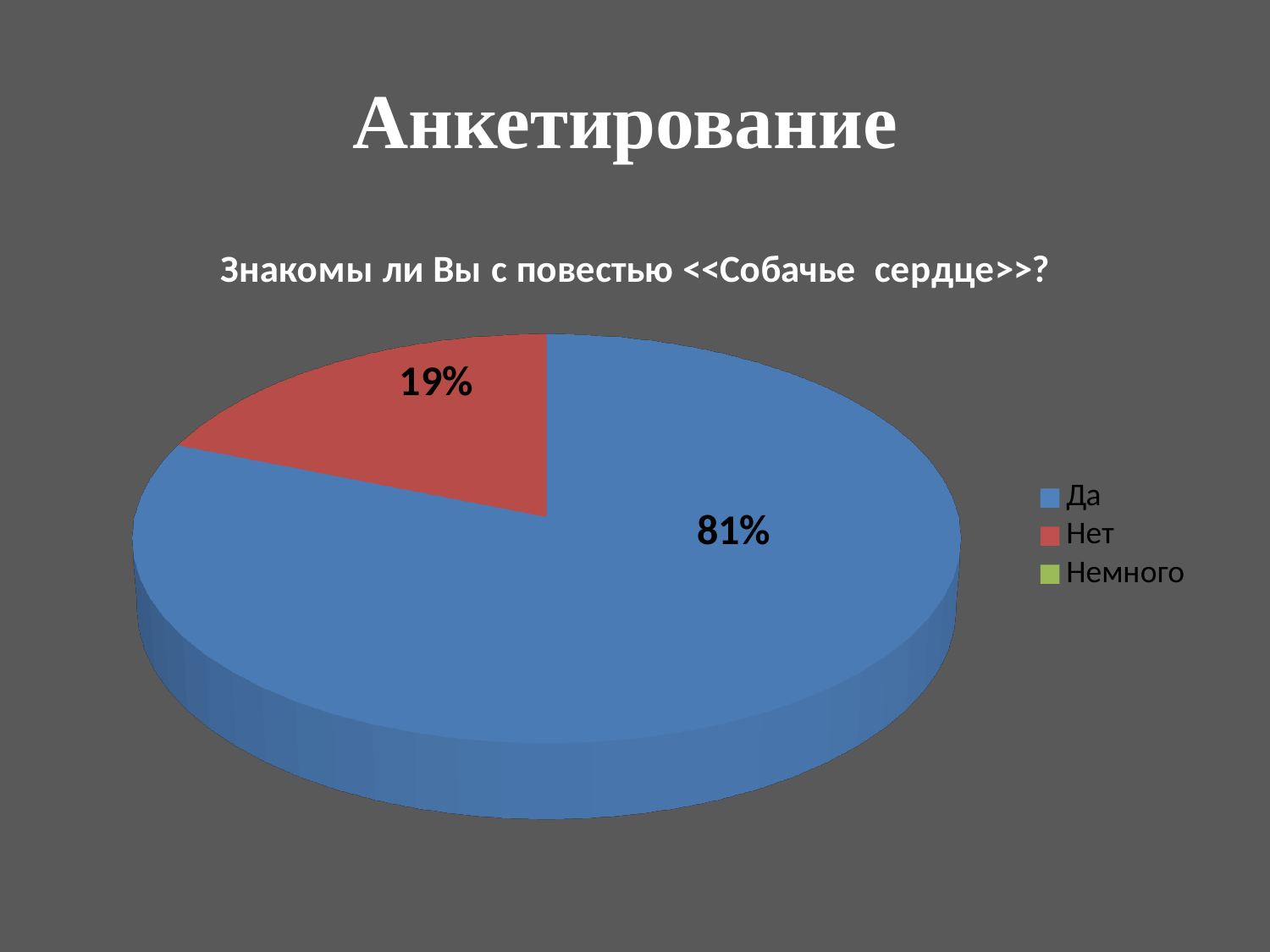
What percentage of respondents answered "Да"? 81% Which answer has the largest share of the pie? Да Which of the labelled slices is the smallest? Нет What share of the pie does the "Да" slice take? 81% Which is larger, the share for "Да" or the share for "Нет"? Да How many slices of the pie carry a data label? 2 What is the chart's title? Знакомы ли Вы с повестью <<Собачье сердце>>? How many entries does the legend list? 3 What kind of chart is shown on the slide? pie chart What colour is the slice for "Нет"? red What percentage of respondents answered "Нет"? 19% By how many percentage points does "Да" exceed "Нет"? 62%